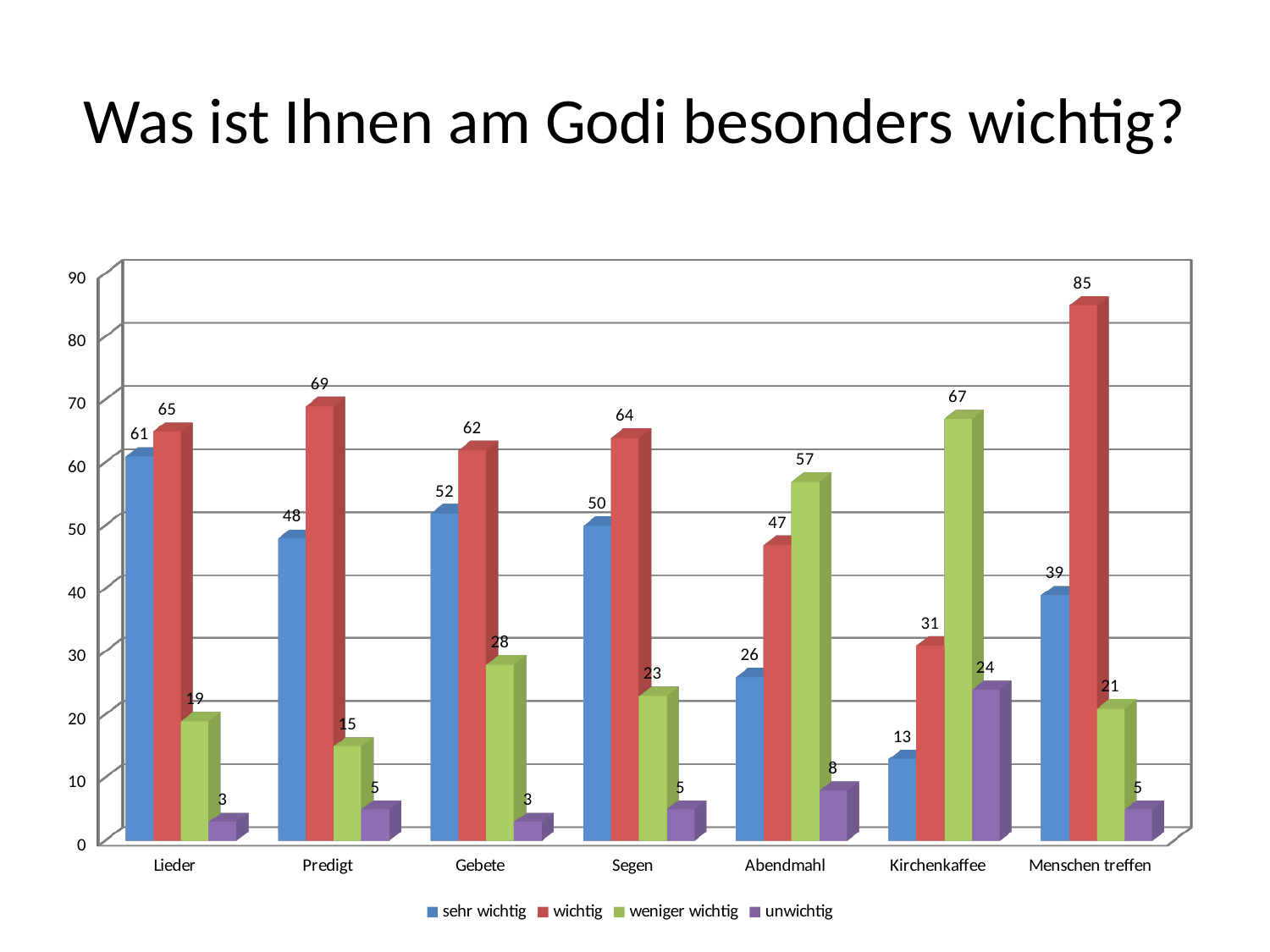
Which category has the lowest value for 'sehr wichtig'? Kirchenkaffee What is the value for 'sehr wichtig' for Lieder? 61 What is the value for 'weniger wichtig' for Kirchenkaffee? 67 What is the difference between the 'wichtig' and 'sehr wichtig' values for Predigt? 21 What kind of chart is shown on the slide? Bar chart Which is larger for Abendmahl: 'wichtig' or 'weniger wichtig'? weniger wichtig Which category has the highest value for 'wichtig'? Menschen treffen What is the title of the slide? Was ist Ihnen am Godi besonders wichtig? How many categories are shown on the x axis? 7 How many series does the legend list? 4 What is the value for 'unwichtig' for Abendmahl? 8 What is the value for 'wichtig' for Menschen treffen? 85